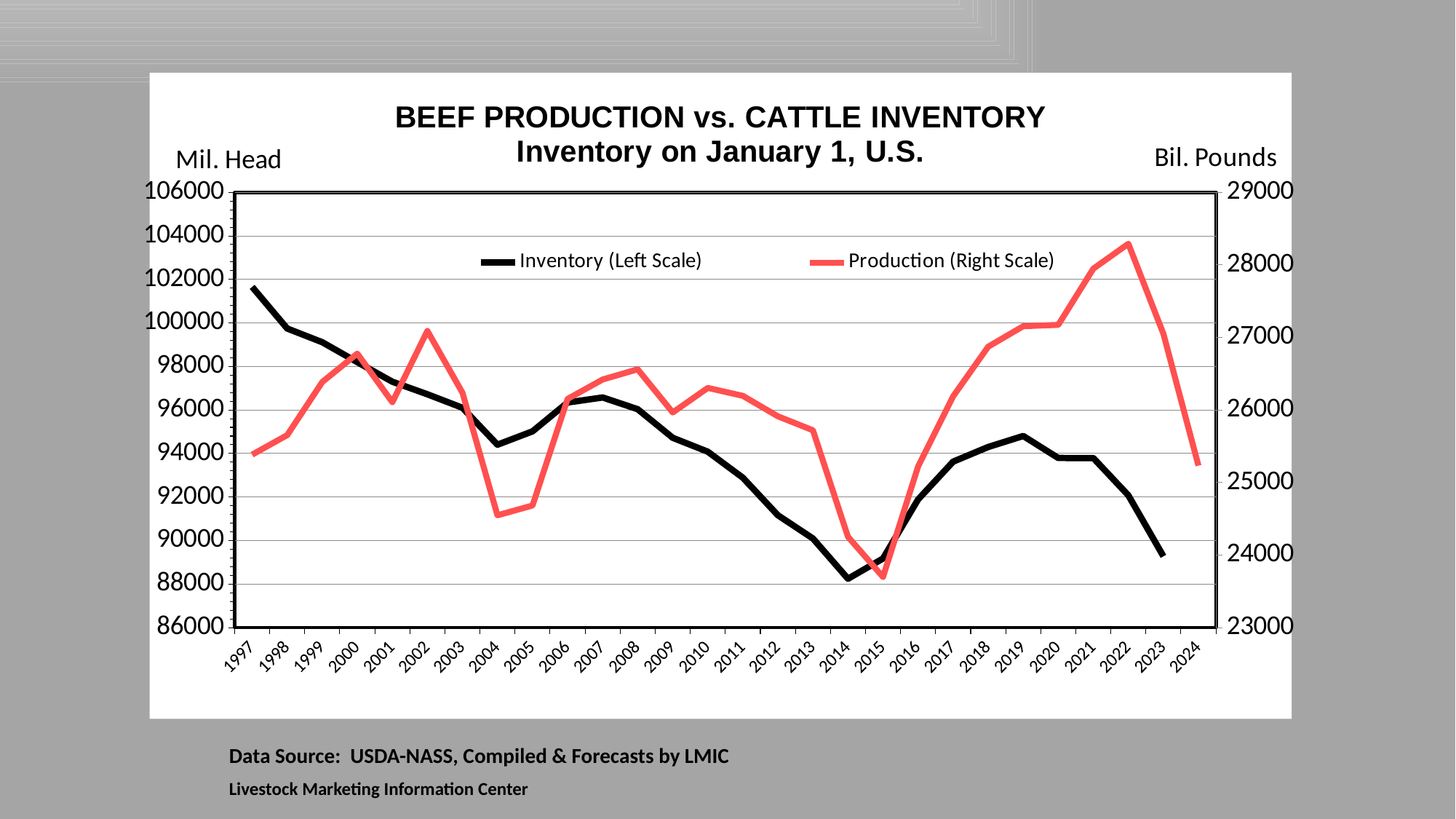
In which year is the Inventory (Left Scale) line at its highest? 1997 Is the Production value for 2024 greater or less than 26000? less Is the Inventory value for 1997 greater or less than 100000? greater How many years are plotted along the x axis? 28 In which year is the Inventory (Left Scale) line at its lowest? 2014 In which year is the Production (Right Scale) line at its highest? 2022 What unit label is shown above the right-hand axis? Bil. Pounds In which year is the Production (Right Scale) line at its lowest? 2015 Which is larger, the Inventory value for 2007 or for 2014? 2007 What kind of chart is shown on the slide? Line chart How many series does the legend list? 2 Does the Inventory line rise or fall from 2019 to 2023? fall